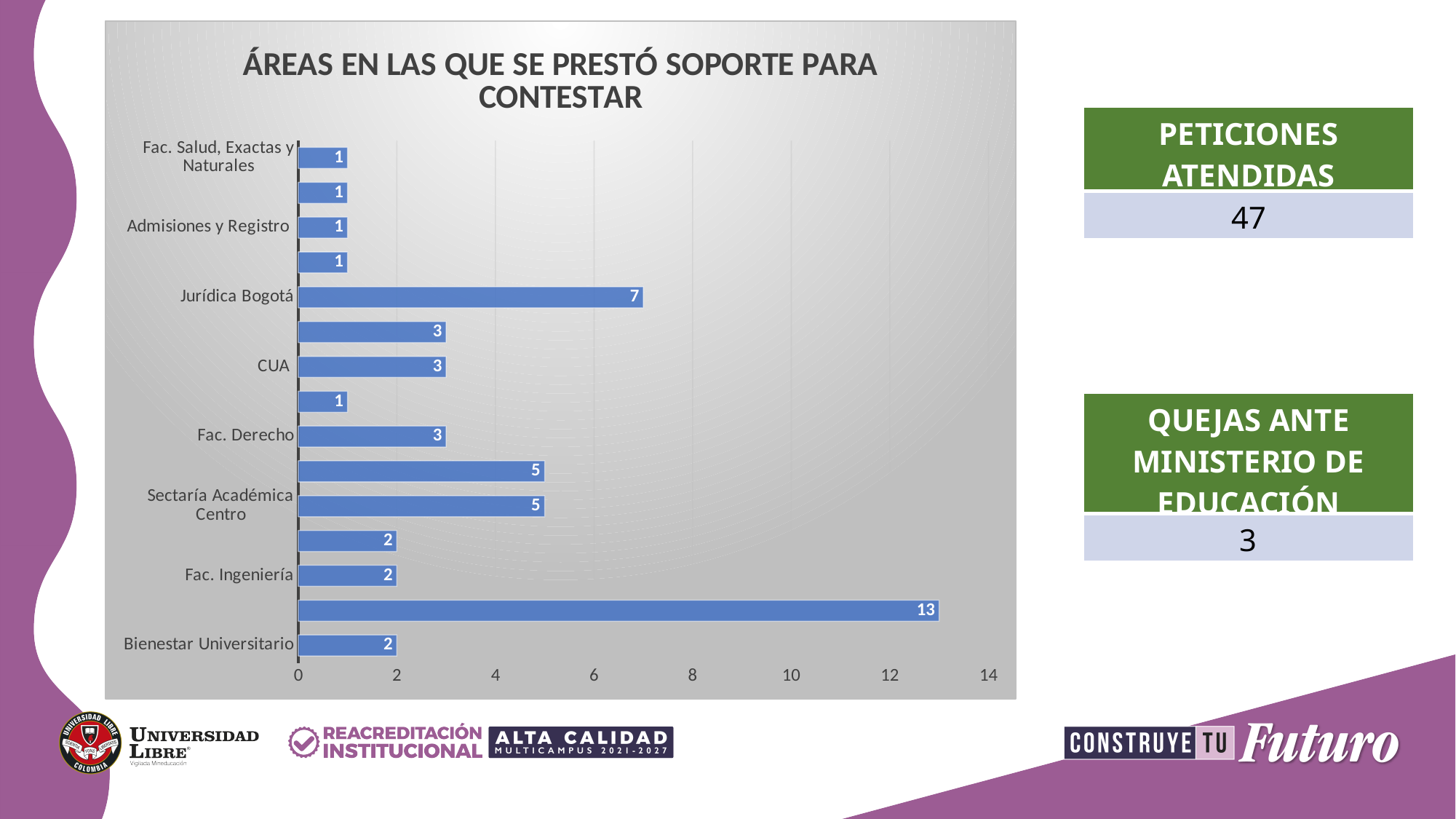
What is the value for Jurídica Bogotá? 7 What is the title of the chart? ÁREAS EN LAS QUE SE PRESTÓ SOPORTE PARA CONTESTAR What is the value for Fac. Derecho? 3 What is the value of the longest bar in the chart? 13 How many bars are plotted in the chart? 15 What is the difference between the values for Jurídica Bogotá and Fac. Derecho? 4 What kind of chart is shown on the slide? bar chart What is the value for Sectaría Académica Centro? 5 What is the difference between the values for Sectaría Académica Centro and Fac. Ingeniería? 3 What is the value for Admisiones y Registro? 1 What is the value for Bienestar Universitario? 2 Which has a larger value, Jurídica Bogotá or CUA? Jurídica Bogotá